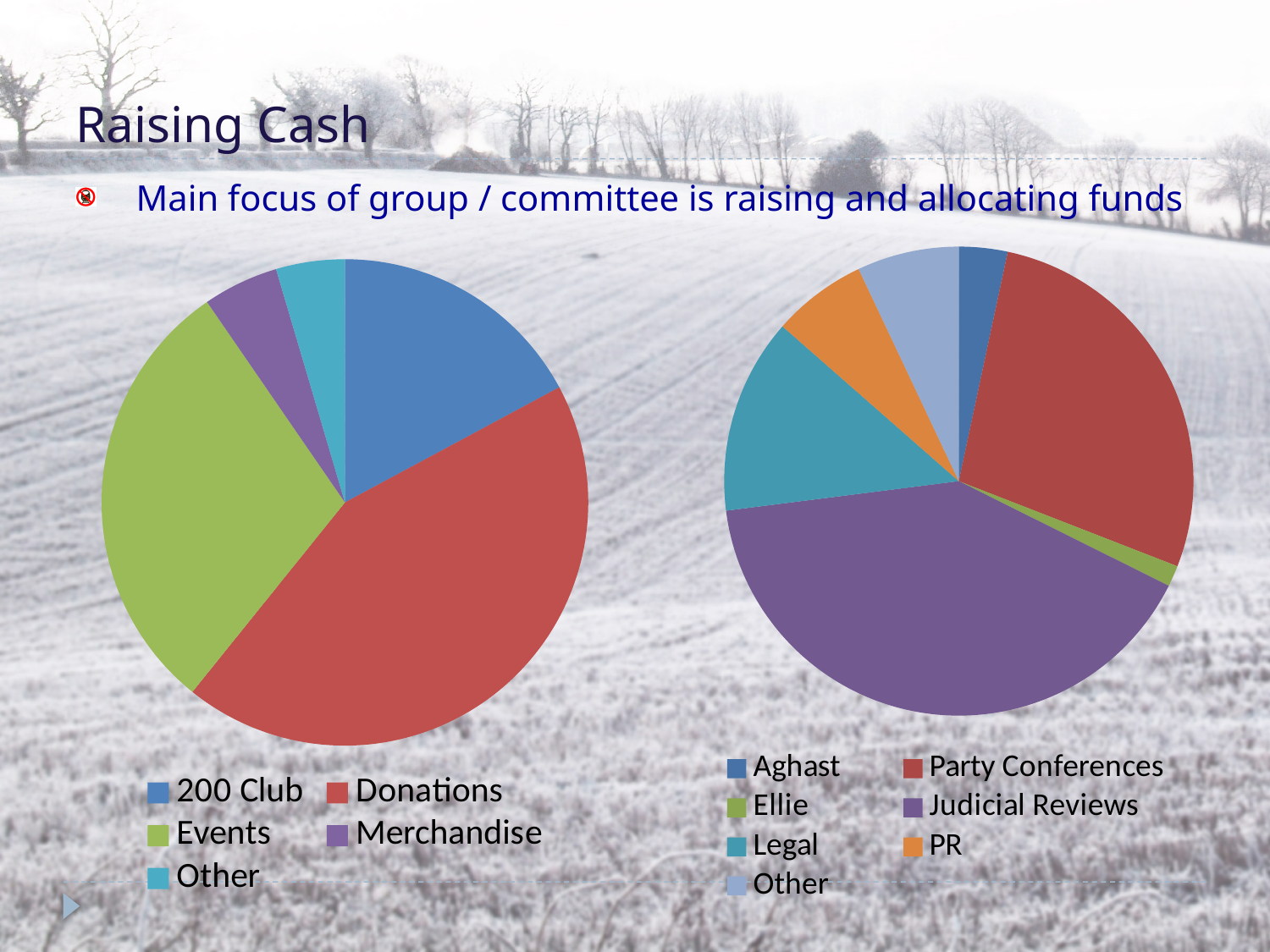
In the left pie chart, which category has the largest slice? Donations In the right pie chart, which category has the largest slice? Judicial Reviews In the right pie chart, which slice is larger, Party Conferences or Legal? Party Conferences What kind of chart is the left chart on the slide? pie chart In the left pie chart, which slice is larger, Donations or Events? Donations In the left pie chart, which slice is larger, Events or 200 Club? Events In the right pie chart, how many categories does the legend list? 7 In the right pie chart, what colour is the Judicial Reviews slice? purple What kind of chart is the right chart on the slide? pie chart In the left pie chart, how many categories does the legend list? 5 In the right pie chart, which category has the smallest slice? Ellie